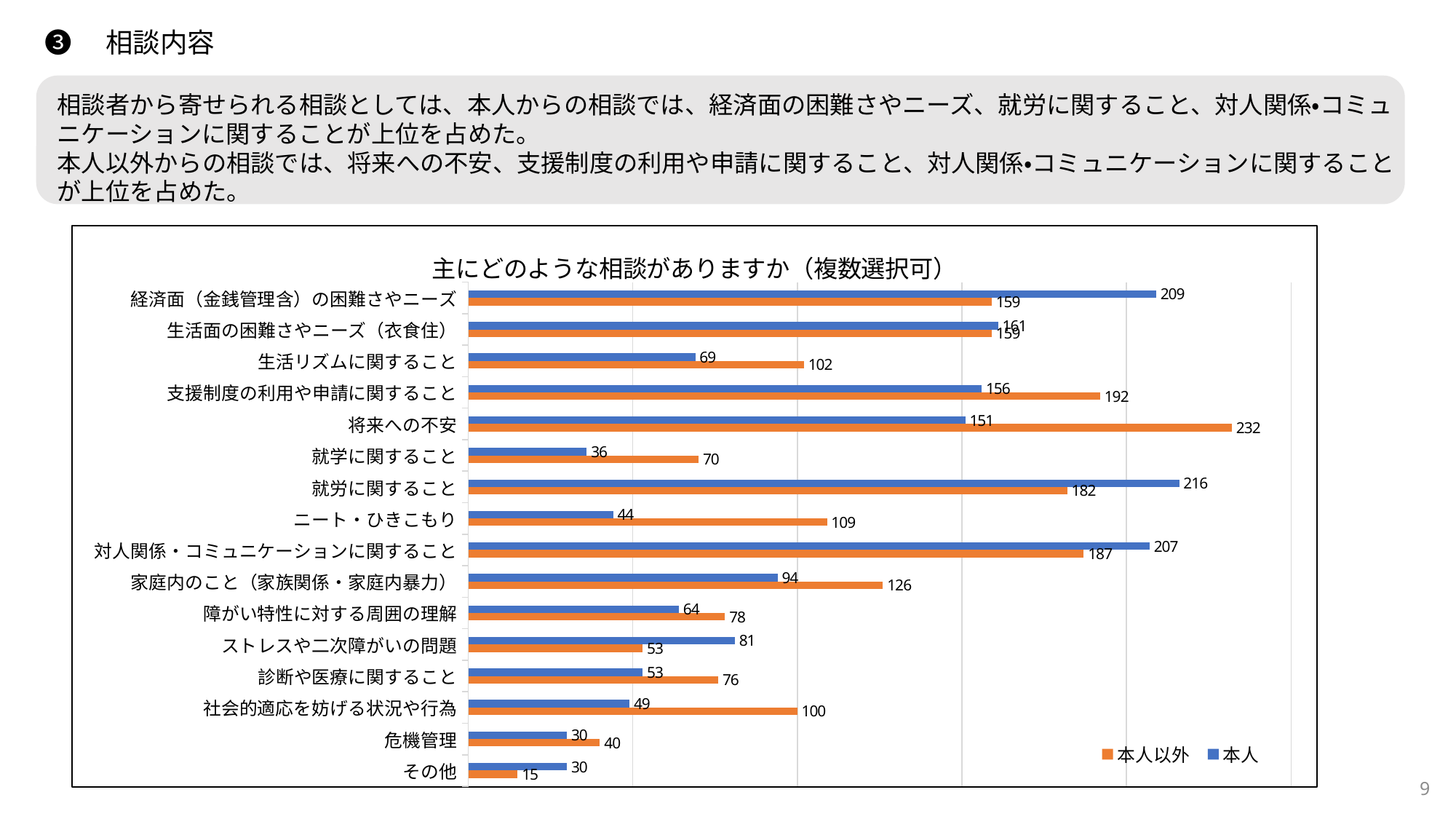
Which category has the highest 本人 value? 就労に関すること For 支援制度の利用や申請に関すること, which is larger: the 本人 value or the 本人以外 value? 本人以外 Which category has the highest 本人以外 value? 将来への不安 How many series does the legend list? 2 What is the 本人以外 value for 将来への不安? 232 What is the difference between the 本人 and 本人以外 values for 経済面（金銭管理含）の困難さやニーズ? 50 Which category has the lowest 本人以外 value? その他 What is the 本人 value for 就労に関すること? 216 What is the 本人以外 value for ニート・ひきこもり? 109 What type of chart is shown on the slide? bar chart What is the title of the chart? 主にどのような相談がありますか（複数選択可） How many categories are plotted in the chart? 16